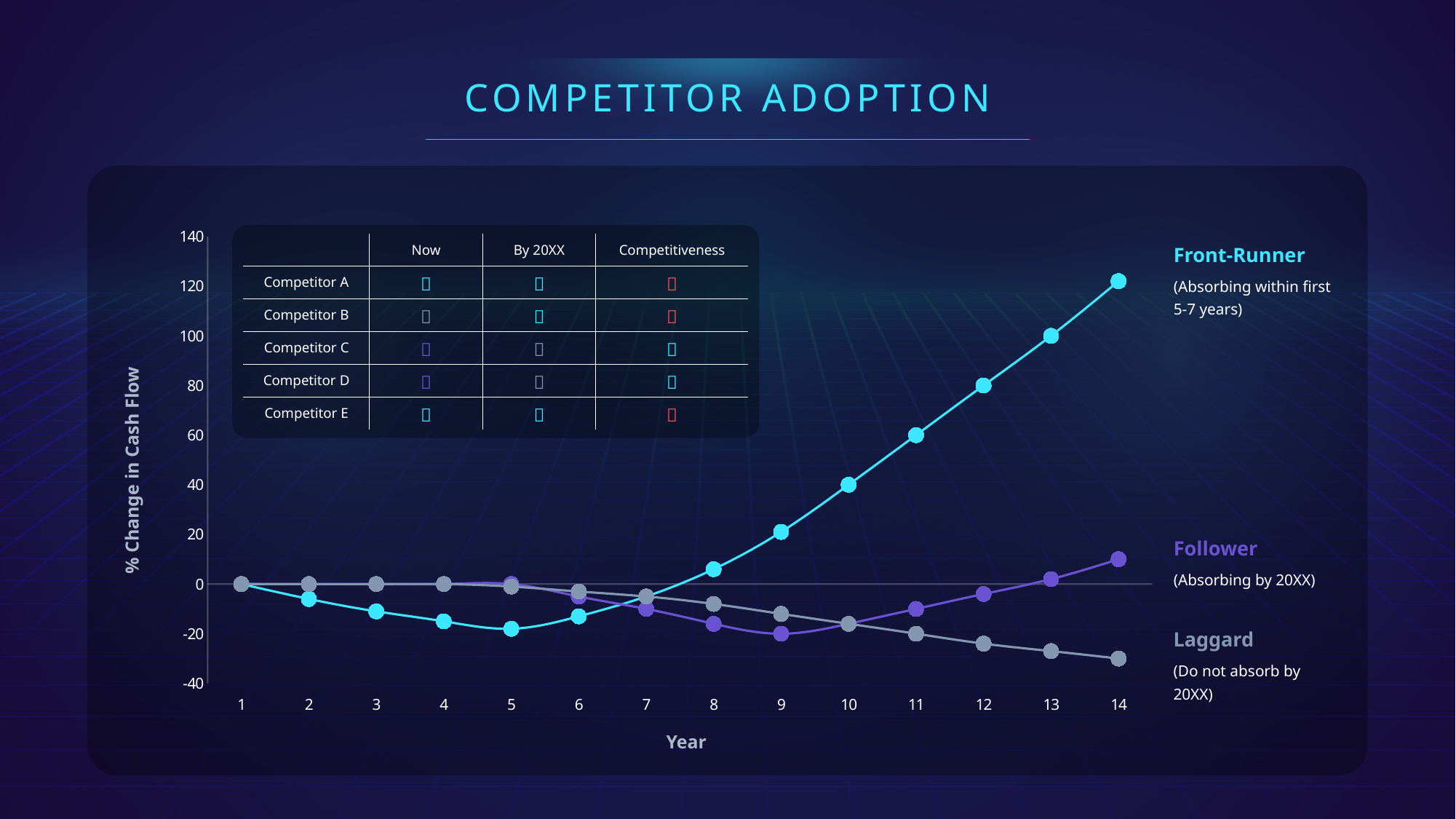
Is the Laggard value at year 14 greater or less than -20? less How many years are shown along the x axis of the chart? 14 What is the Front-Runner value at year 13? 100 What is the Front-Runner value at year 10? 40 What is the difference between the Front-Runner values at year 13 and year 11? 40 Does the Laggard series rise or fall from year 5 to year 14? fall Which series has the highest value at year 14? Front-Runner Is the Front-Runner value at year 5 greater or less than 0? less What is the Front-Runner value at year 12? 80 What is the title of the y axis? % Change in Cash Flow How many series are plotted on the chart? 3 What kind of chart is shown on the slide? line chart